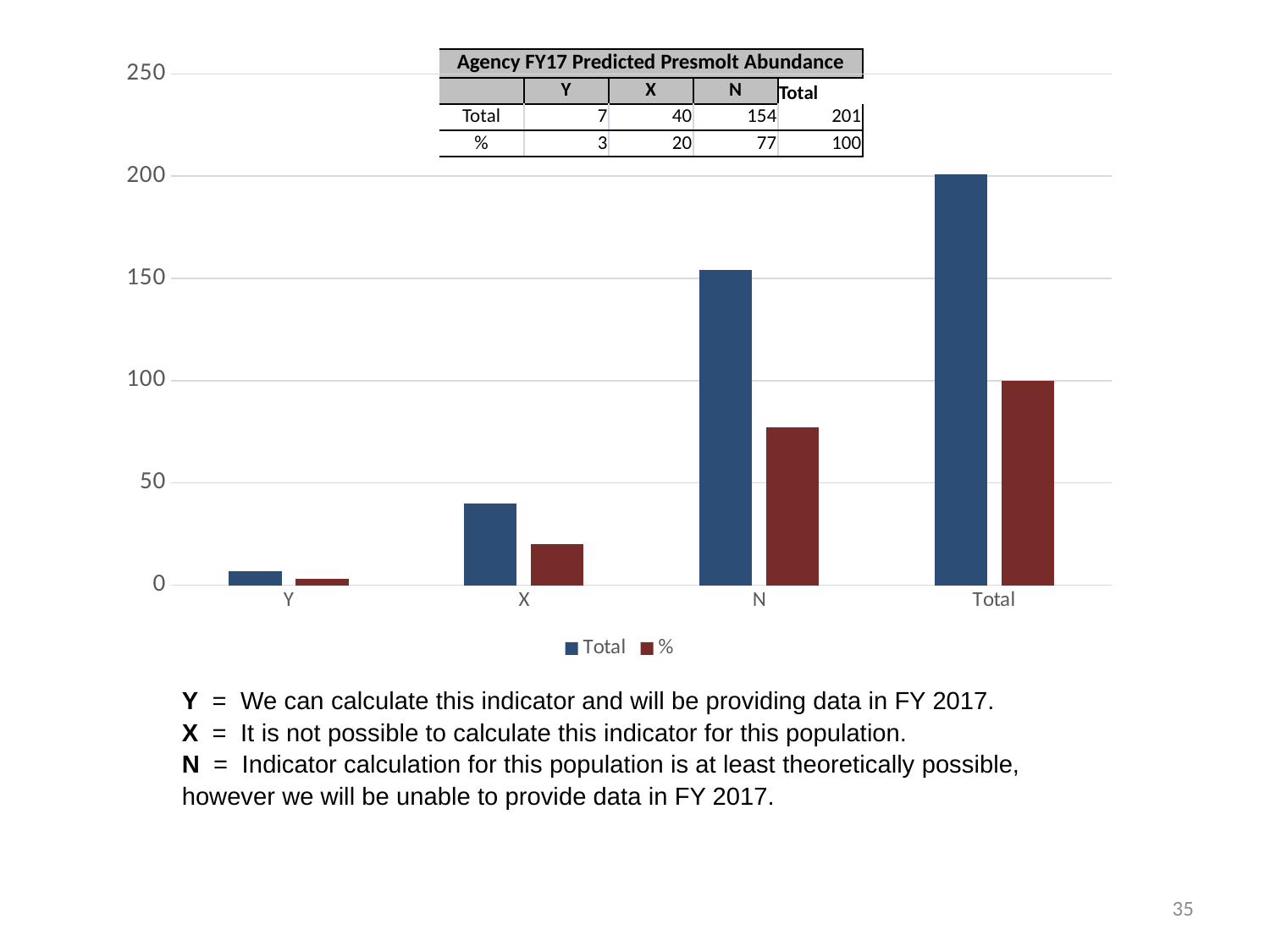
What is the % value for category N? 77 What is the Total value for category N? 154 What kind of chart is shown on the slide? bar chart Among Y, X and N, which category has the highest Total value? N Which category has the lowest Total value? Y Which is larger, the Total value for X or the Total value for N? N What is the title of the data table shown above the chart? Agency FY17 Predicted Presmolt Abundance How many categories are shown on the x axis? 4 What is the % value for category X? 20 How many series does the legend list? 2 What is the Total value for category Y? 7 What is the difference between the Total values for N and X? 114